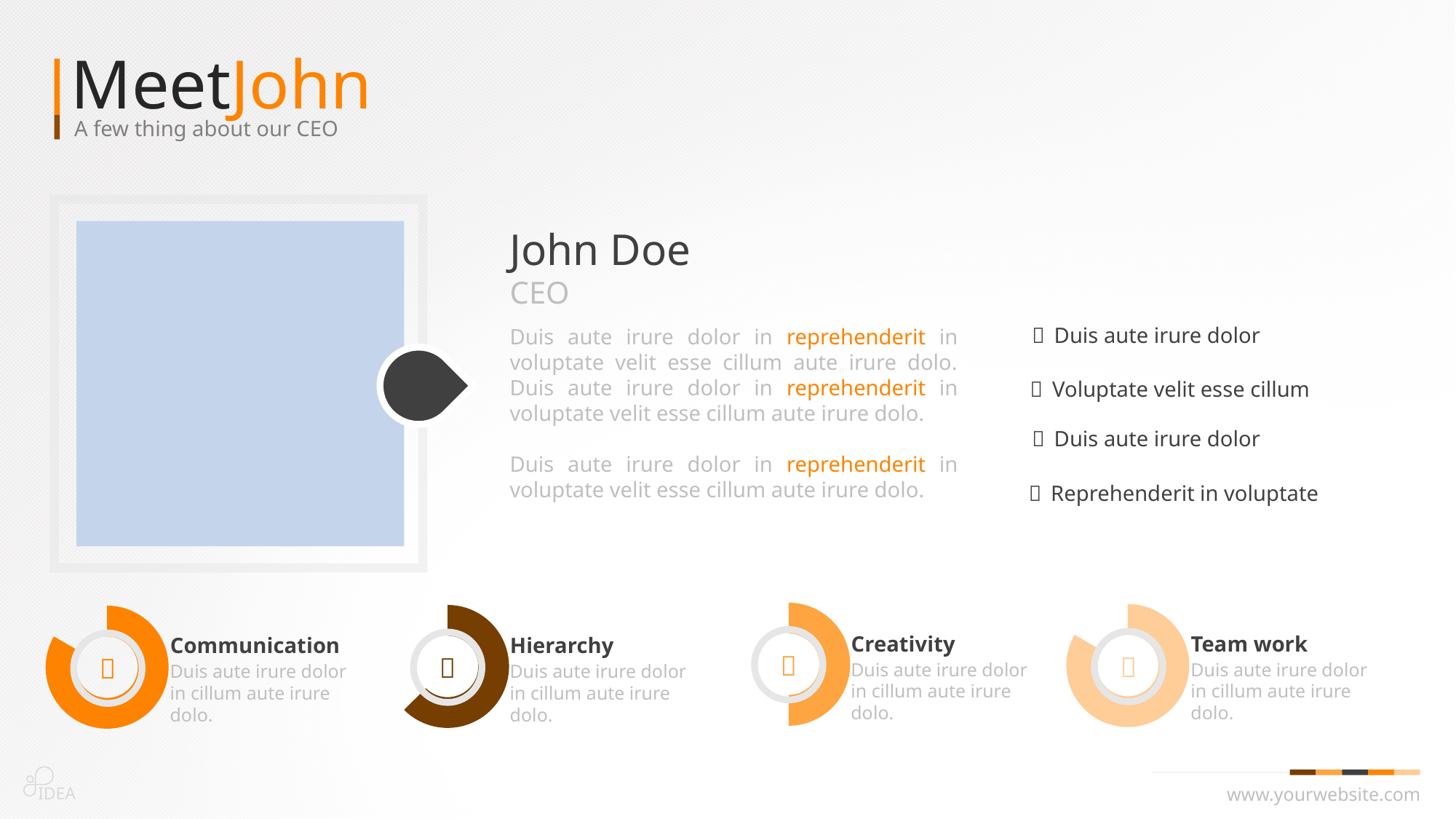
What kind of chart is used for the four indicators at the bottom of the slide (Communication, Hierarchy, Creativity, Team work)? doughnut chart How many doughnut charts are shown along the bottom of the slide? 4 Comparing the Communication and Creativity doughnut charts, which one has the larger filled portion of its ring? Communication What colour is the filled ring of the Hierarchy doughnut chart? dark brown What colour is the filled ring of the Communication doughnut chart? orange Which doughnut chart at the bottom of the slide is labelled last on the right? Team work Is the filled portion of the Communication doughnut chart greater or less than half of the ring? greater Which doughnut chart at the bottom of the slide is labelled first from the left? Communication